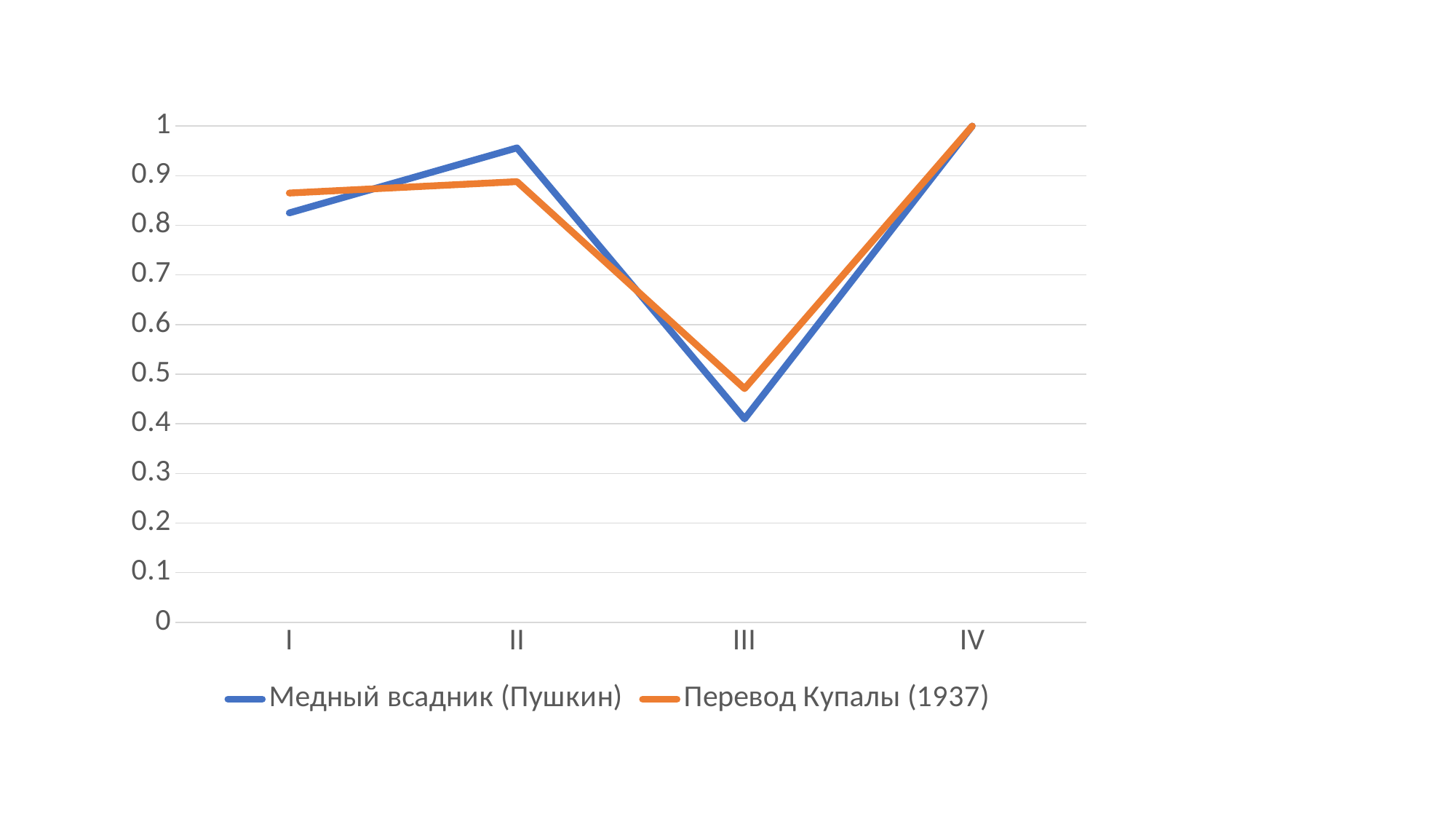
What is the value of Перевод Купалы (1937) at IV? 1 What is the value of Медный всадник (Пушкин) at IV? 1 What kind of chart is shown on the slide? line chart How many series does the legend list? 2 How many categories are shown on the x axis? 4 At III, which series has the higher value, Медный всадник (Пушкин) or Перевод Купалы (1937)? Перевод Купалы (1937) At which category is the value for Медный всадник (Пушкин) lowest? III At II, which series has the higher value, Медный всадник (Пушкин) or Перевод Купалы (1937)? Медный всадник (Пушкин) Is the value for Перевод Купалы (1937) at III greater or less than 0.6? less Is the value for Медный всадник (Пушкин) at III greater or less than 0.5? less Is the value for Медный всадник (Пушкин) at II greater or less than 0.9? greater At which category is the value for Перевод Купалы (1937) highest? IV